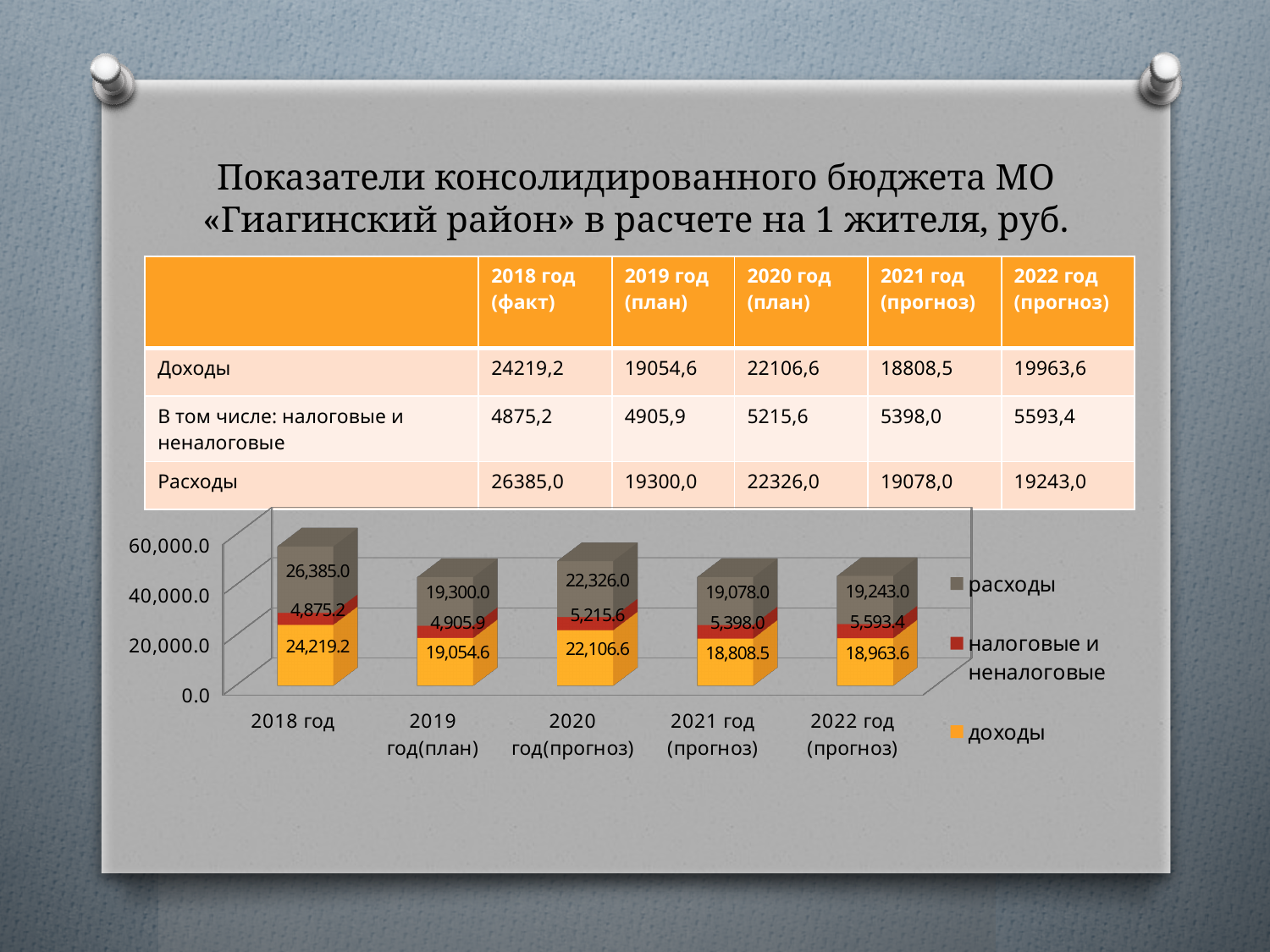
In the chart, what is the total of the stacked bar for 2018 год? 55,479.4 In the chart, do the values of налоговые и неналоговые rise or fall from 2018 год to 2022 год (прогноз)? rise In the chart, what is the value of доходы for 2018 год? 24,219.2 In the chart, which year has the highest value of расходы? 2018 год What type of chart is shown on the slide? stacked bar chart How many series does the chart legend list? 3 In the chart, what is the difference between расходы for 2018 год and расходы for 2019 год(план)? 7,085.0 In the chart, is the value of расходы larger for 2020 год(прогноз) or for 2021 год (прогноз)? 2020 год(прогноз) In the chart, what is the value of налоговые и неналоговые for 2022 год (прогноз)? 5,593.4 In the chart, what is the value of расходы for 2020 год(прогноз)? 22,326.0 In the chart, which year has the lowest value of доходы? 2021 год (прогноз) How many year categories are plotted on the chart's x axis? 5